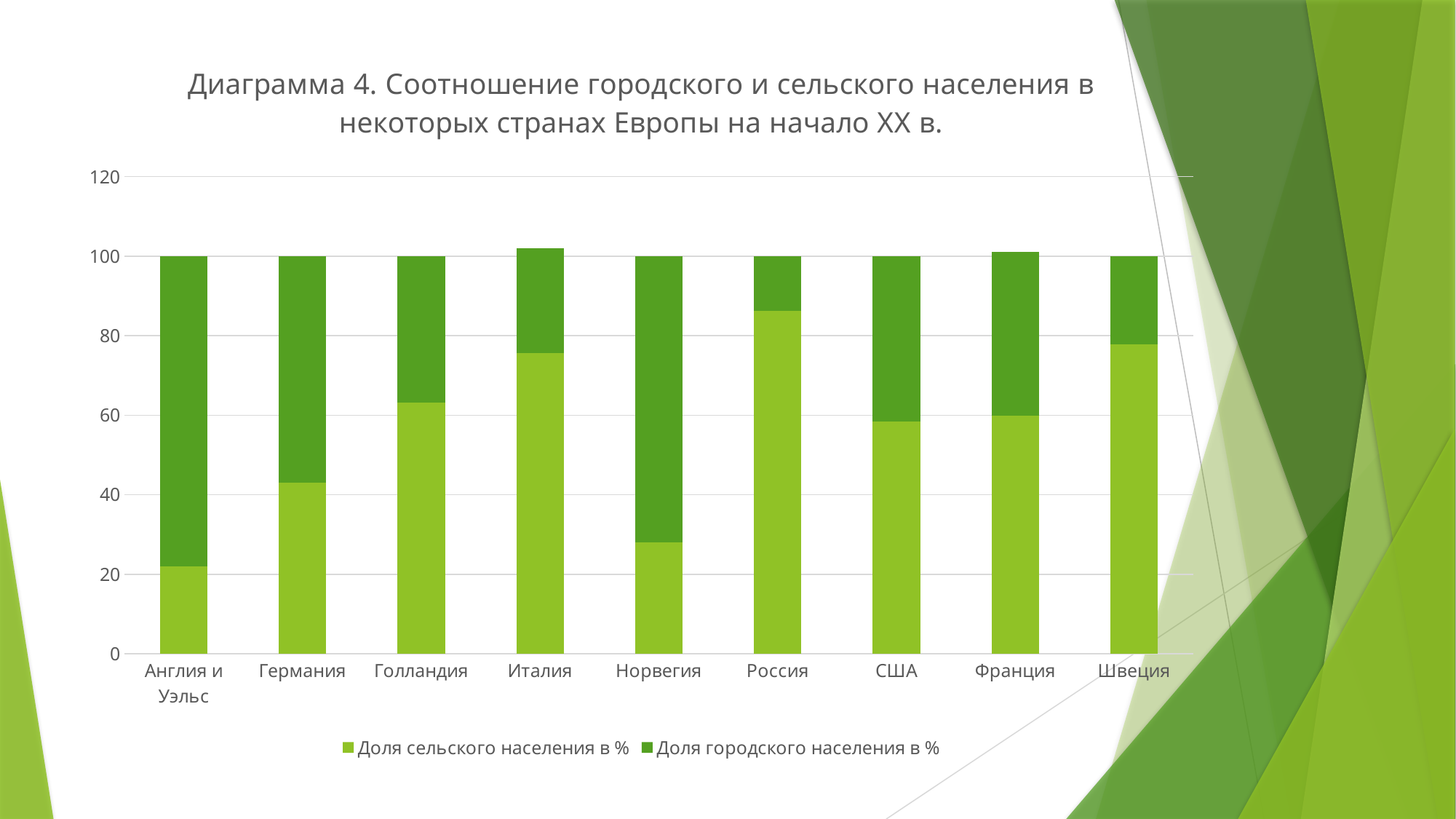
Which country has the highest share of rural population (Доля сельского населения в %)? Россия How many series does the legend list? 2 Which country has the lowest share of rural population (Доля сельского населения в %)? Англия и Уэльс Is the rural population share for Норвегия greater or less than 40? less Is the rural population share for Италия greater or less than 60? greater What is the title of the chart? Диаграмма 4. Соотношение городского и сельского населения в некоторых странах Европы на начало XX в. Is the rural population share for Англия и Уэльс greater or less than 40? less Which has the larger rural population share, Италия or Германия? Италия How many countries (categories) are shown on the x axis? 9 Which country has the largest urban population share (Доля городского населения в %)? Англия и Уэльс What kind of chart is shown on the slide? stacked bar chart